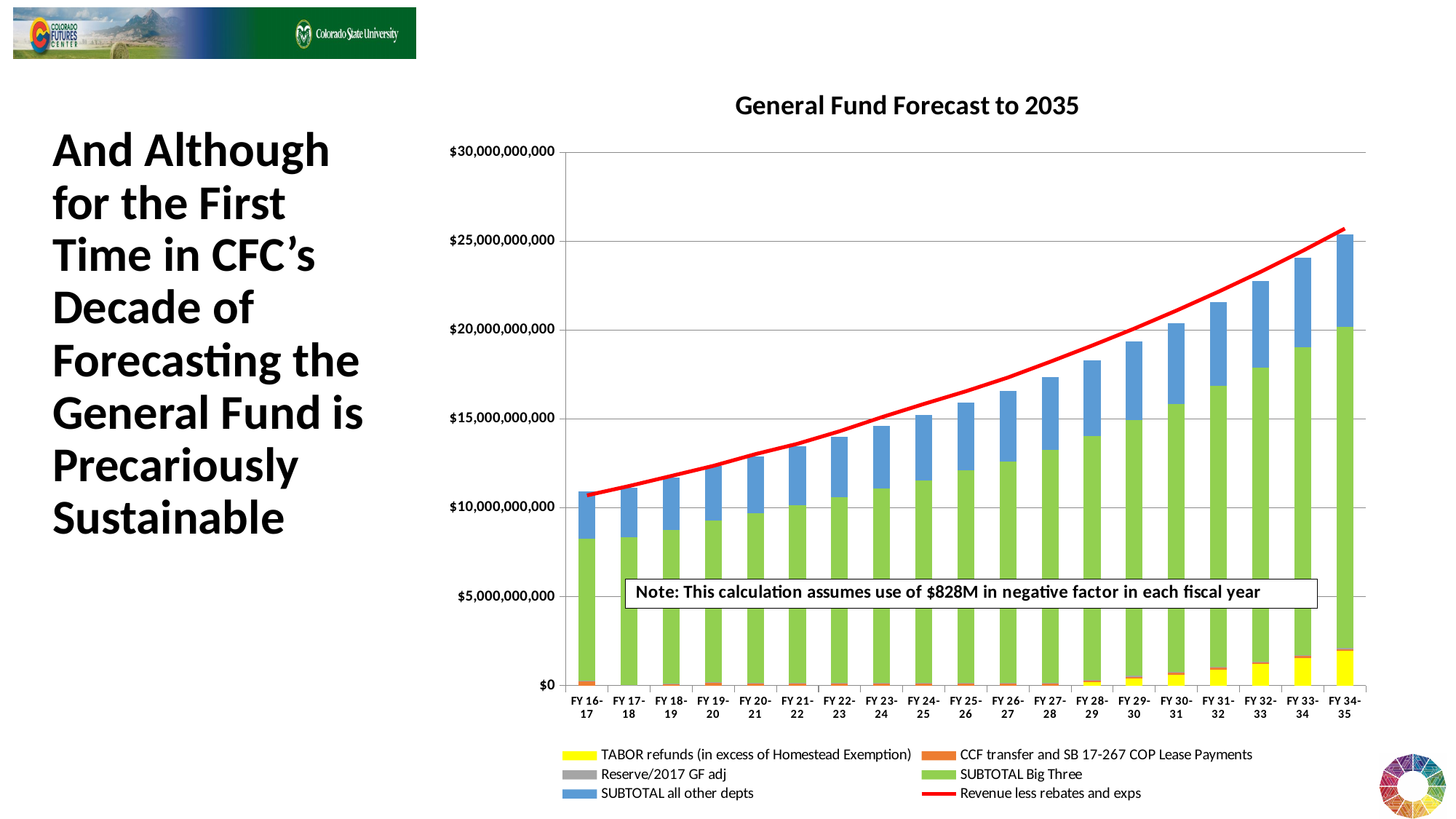
What is the title of the chart on the slide? General Fund Forecast to 2035 Which series in the General Fund Forecast chart is drawn as a red line? Revenue less rebates and exps How many series does the legend of the General Fund Forecast chart list? 6 How many fiscal years are shown along the x axis of the General Fund Forecast chart? 19 Which fiscal year has the tallest stacked bar in the General Fund Forecast chart? FY 34-35 Is the total stacked bar for FY 16-17 greater or less than $15,000,000,000? less Do the stacked bar totals in the General Fund Forecast chart rise or fall from FY 16-17 to FY 34-35? rise Which is larger, the total stacked bar for FY 34-35 or for FY 16-17? FY 34-35 Is the total stacked bar for FY 34-35 greater or less than $20,000,000,000? greater Which fiscal year has the shortest stacked bar in the General Fund Forecast chart? FY 16-17 Is the total stacked bar for FY 25-26 greater or less than $20,000,000,000? less What kind of chart is used to show the General Fund Forecast to 2035? stacked bar chart with a line